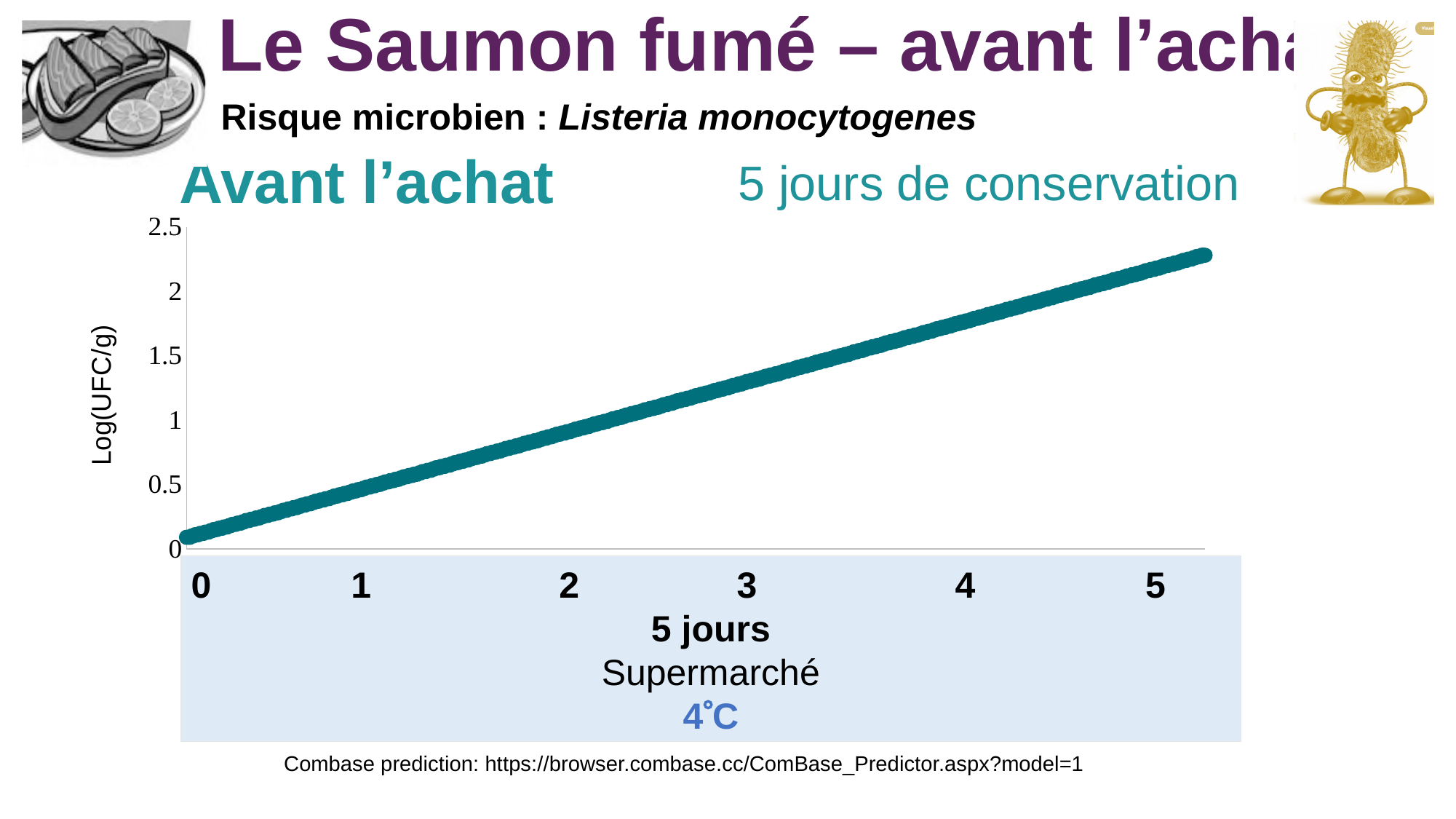
What storage temperature is indicated below the chart? 4°C Which is larger, the Log(UFC/g) value at day 1 or at day 4? day 4 Is the value of Log(UFC/g) at day 4 greater or less than 2? less Is the value of Log(UFC/g) at day 4 greater or less than 1.5? greater At which day on the x axis is the Log(UFC/g) value highest? 5 What kind of chart is shown on the slide? line chart Is the value of Log(UFC/g) at day 3 greater or less than 1? greater At which day on the x axis is the Log(UFC/g) value lowest? 0 What is the label of the y axis? Log(UFC/g) Do the values rise or fall as the number of days increases along the x axis? rise